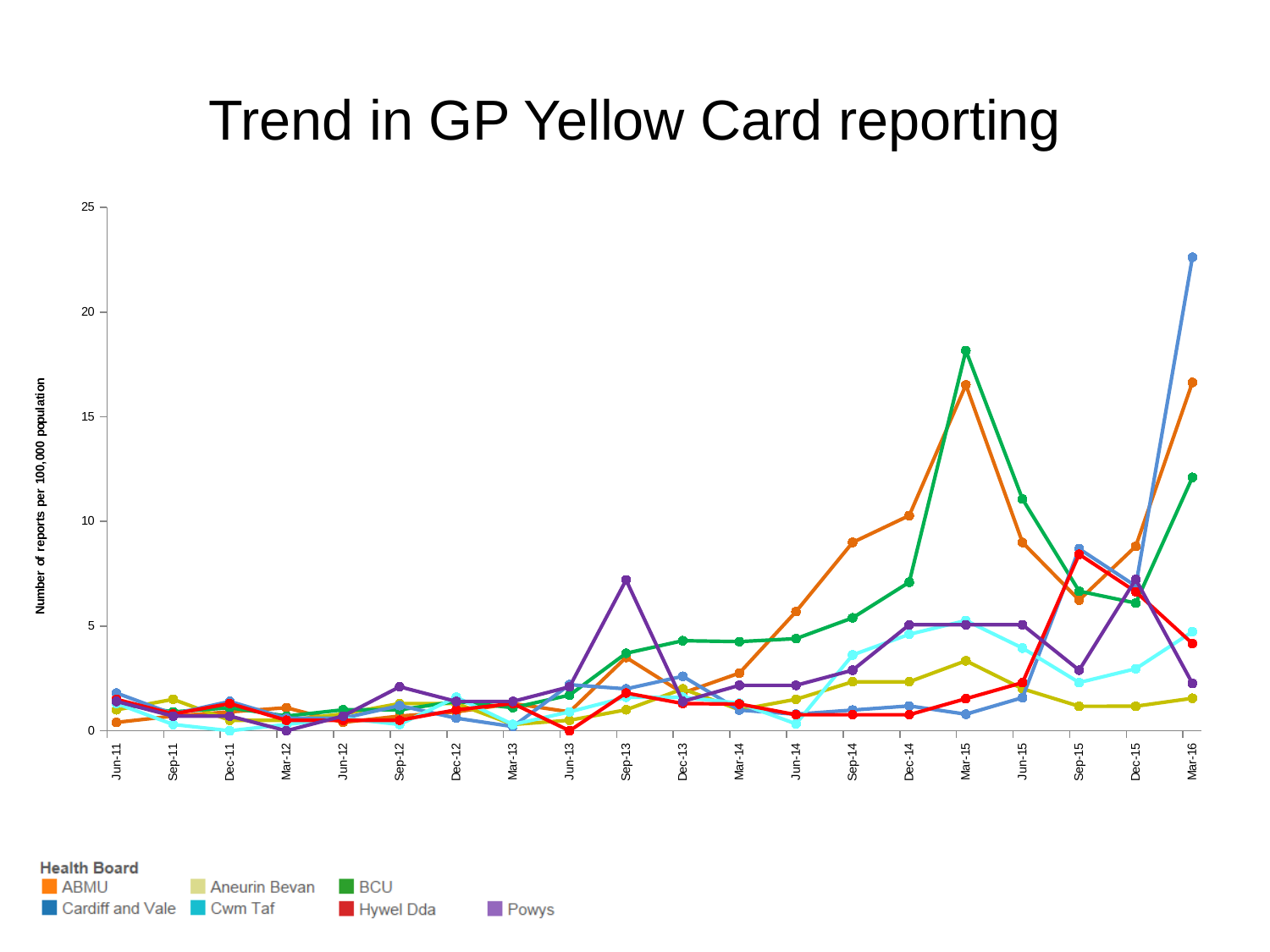
Is the value for BCU at Mar-15 greater or less than 15? greater Is the value for Powys at Sep-13 greater or less than 5? greater Which health board has the highest value at Mar-16? Cardiff and Vale At Mar-16, which is larger: the value for ABMU or the value for BCU? ABMU Which health board has the highest value at Mar-15? BCU Is the value for Cardiff and Vale at Mar-16 greater or less than 20? greater How many health boards does the legend list? 7 What kind of chart is shown on the slide? line chart What is the label on the y axis? Number of reports per 100,000 population How many time points are shown along the x axis? 20 Does the ABMU line generally rise or fall from Jun-11 to Mar-16? rise